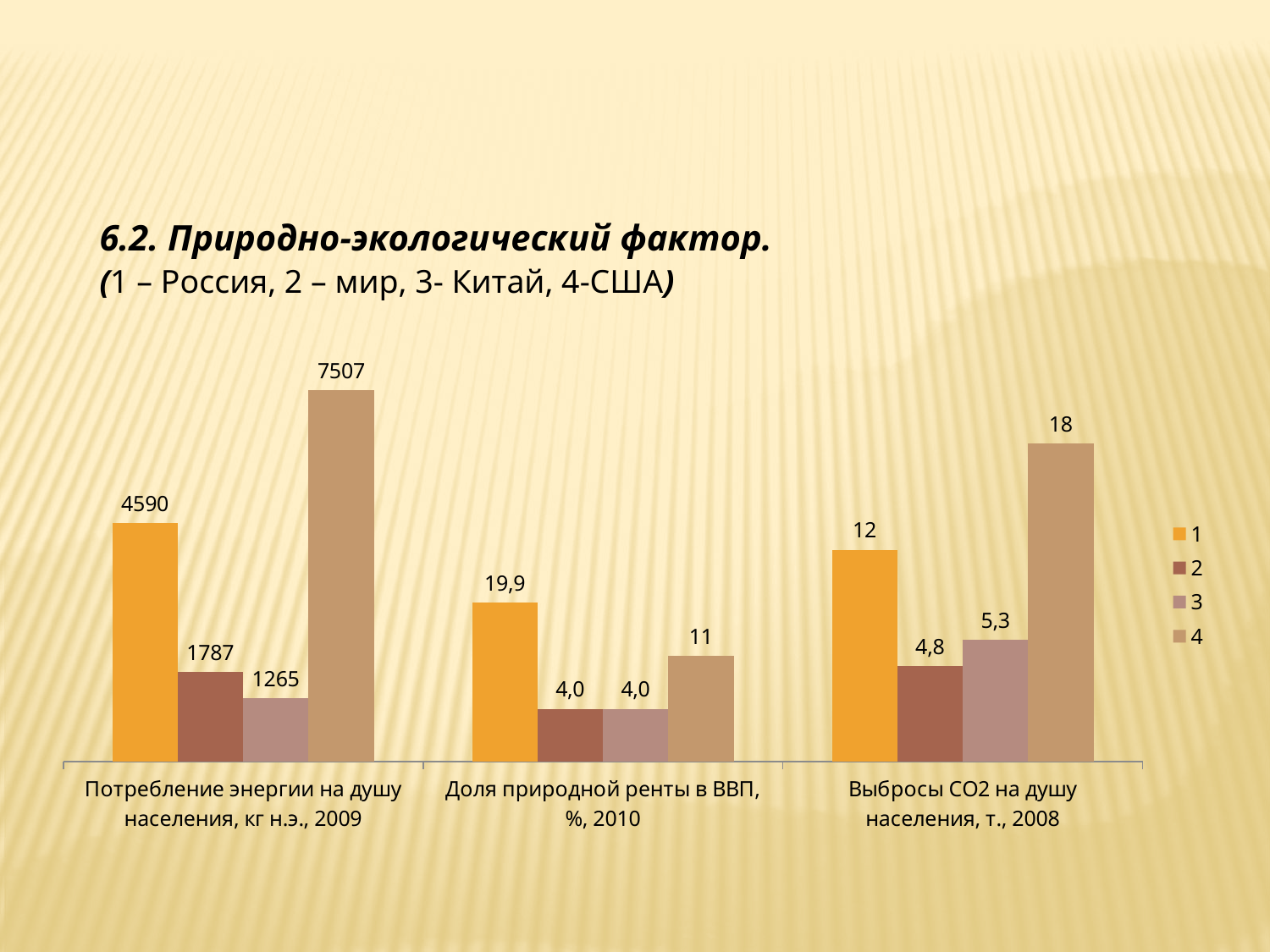
What is the value for series 3 in the category "Выбросы CO2 на душу населения, т., 2008"? 5,3 According to the subtitle, which country does series 3 represent? Китай What is the difference between series 4 and series 1 in the category "Выбросы CO2 на душу населения, т., 2008"? 6 What is the difference between series 4 and series 1 in the category "Потребление энергии на душу населения, кг н.э., 2009"? 2917 How many series does the legend list? 4 What is the value for series 1 in the category "Доля природной ренты в ВВП, %, 2010"? 19,9 In the category "Доля природной ренты в ВВП, %, 2010", which is larger: series 1 or series 4? series 1 Which series has the lowest value in the category "Выбросы CO2 на душу населения, т., 2008"? 2 How many categories are shown on the x axis? 3 Which series has the highest value in the category "Потребление энергии на душу населения, кг н.э., 2009"? 4 What kind of chart is shown on the slide? bar chart What is the value for series 4 in the category "Потребление энергии на душу населения, кг н.э., 2009"? 7507